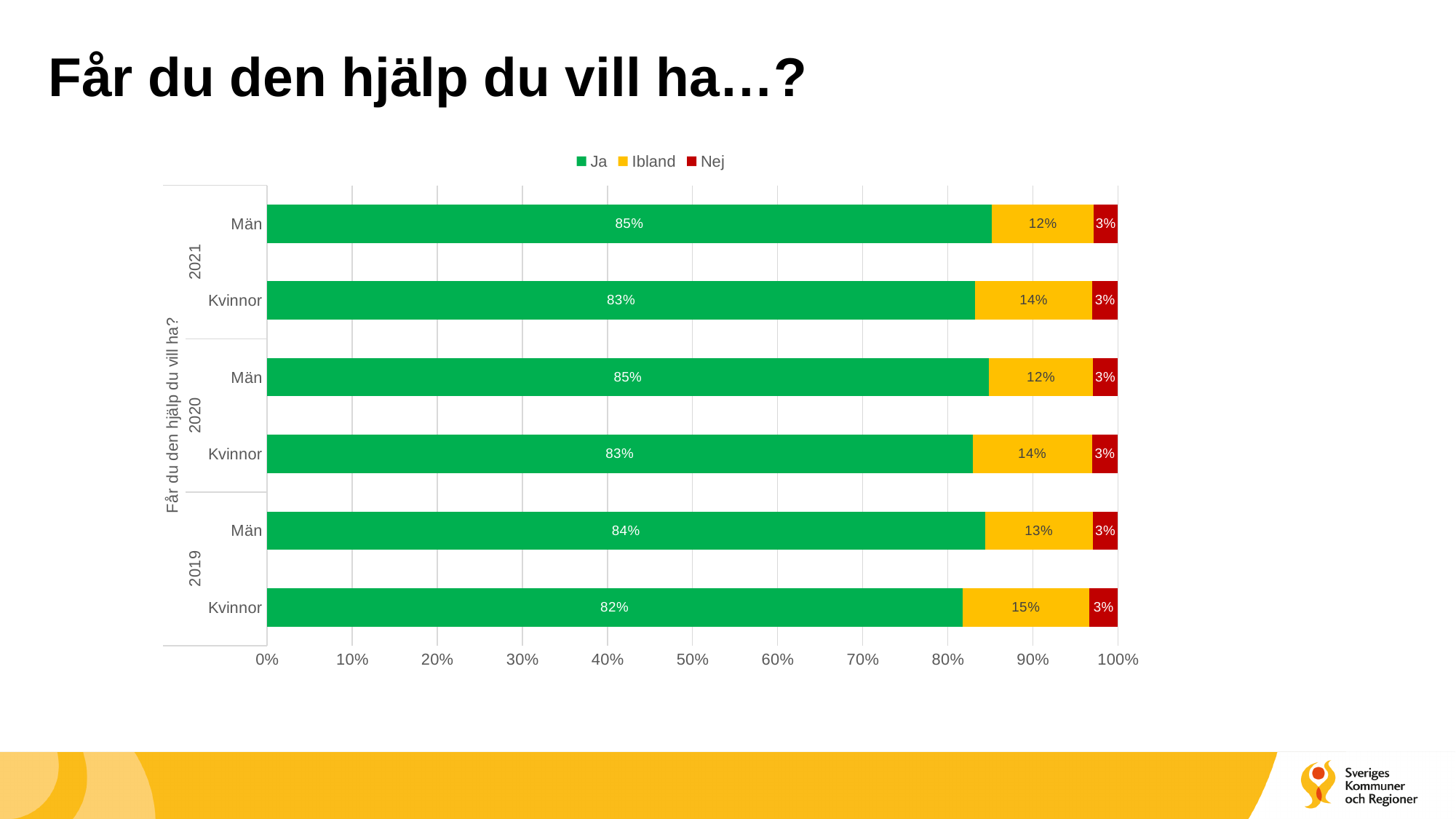
What is the total of the stacked bar for men in 2020? 100% What percentage of men in 2019 answered "Ja"? 84% How many bars are shown in the chart? 6 Which colour represents the "Nej" series? Red What is the difference between the "Ja" share for men and women in 2021? 2 percentage points What kind of chart is shown on the slide? Stacked bar chart How many series does the legend list? 3 What percentage of women in 2019 answered "Ibland"? 15% Which is larger: the "Ibland" share for women in 2019 or for men in 2019? Kvinnor 2019 What percentage of women in 2020 answered "Nej"? 3% What percentage of men in 2021 answered "Ja"? 85% Which group has the lowest "Ja" share? Kvinnor 2019